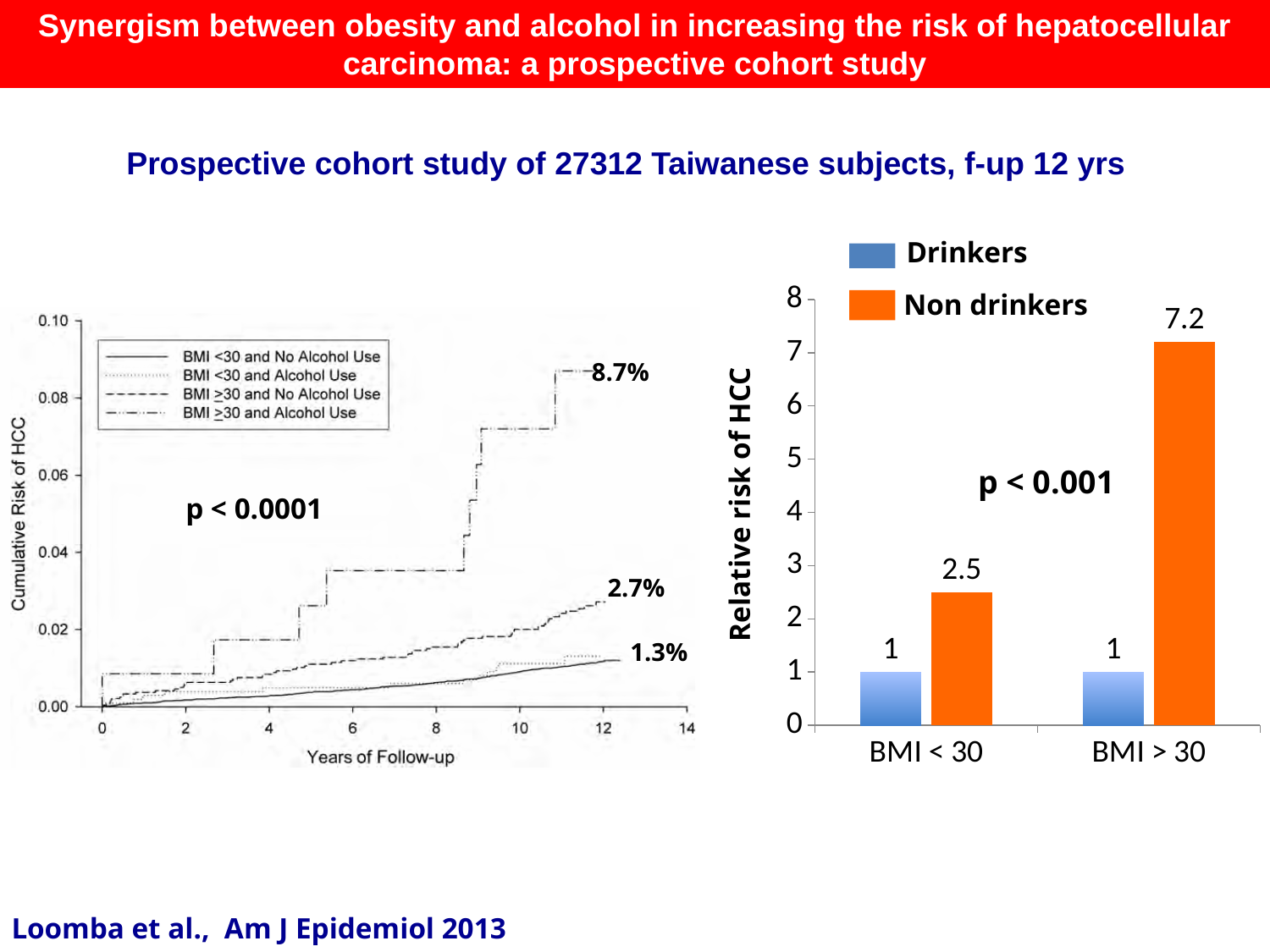
On the right-hand chart (Relative risk of HCC), what p-value is shown? p < 0.001 What kind of chart is the right-hand chart (Relative risk of HCC)? Bar chart On the right-hand chart (Relative risk of HCC), what is the value for Drinkers in the BMI > 30 group? 1 On the right-hand chart (Relative risk of HCC), what colour are the Non drinkers bars? Orange On the right-hand chart (Relative risk of HCC), which bar has the highest value? Non drinkers, BMI > 30 On the right-hand chart (Relative risk of HCC), what is the difference between the Non drinkers values for BMI > 30 and BMI < 30? 4.7 On the right-hand chart (Relative risk of HCC), which is larger: the Non drinkers value for BMI < 30 or the Drinkers value for BMI < 30? Non drinkers On the left-hand chart (Cumulative Risk of HCC), what is the highest labelled cumulative risk value at the end of follow-up? 8.7% How many series does the legend of the right-hand chart (Relative risk of HCC) list? 2 On the right-hand chart (Relative risk of HCC), what is the value for Non drinkers in the BMI > 30 group? 7.2 How many series does the legend of the left-hand chart (Cumulative Risk of HCC) list? 4 On the right-hand chart (Relative risk of HCC), what is the value for Non drinkers in the BMI < 30 group? 2.5